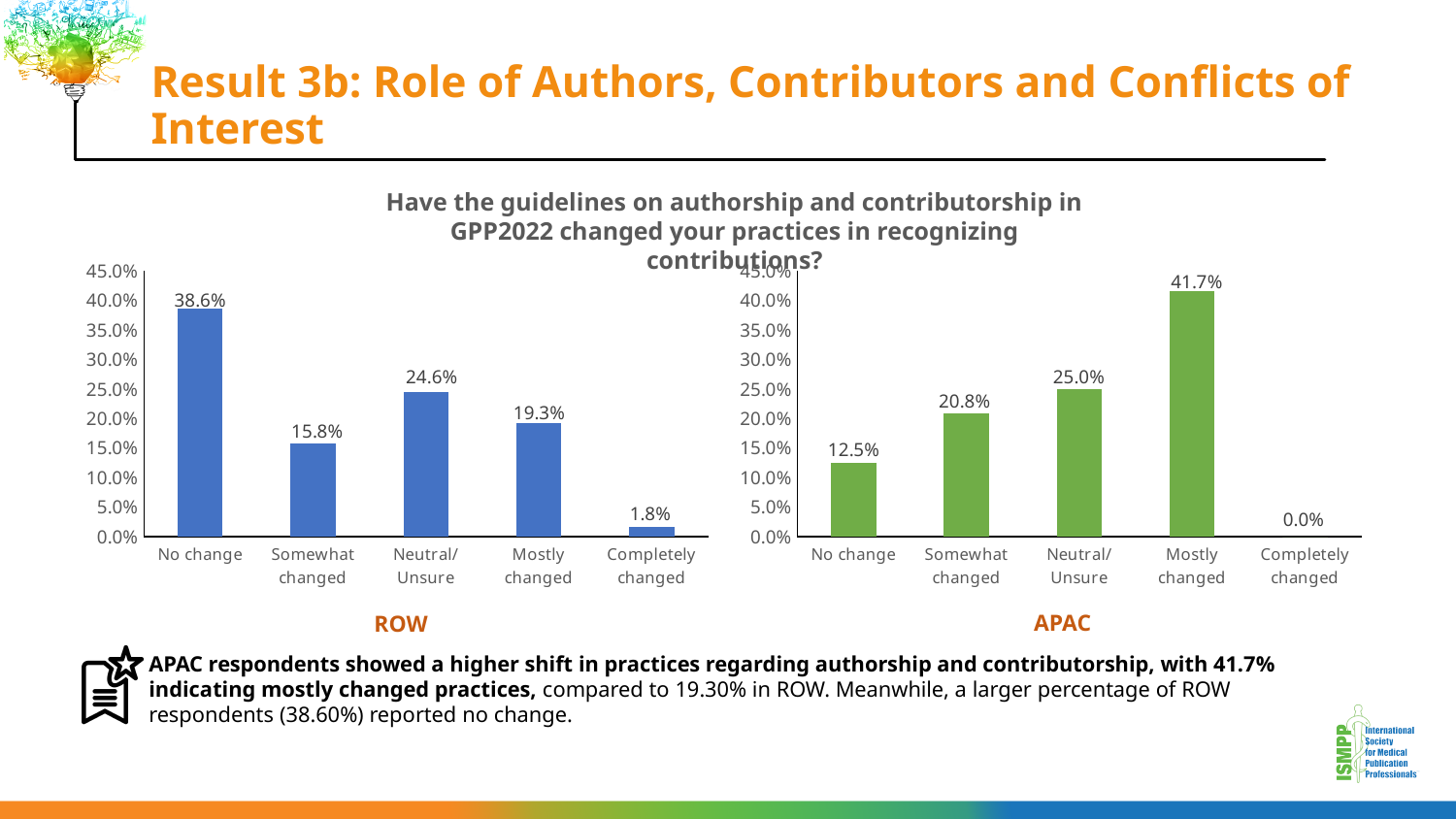
In the ROW chart, what is the value for No change? 38.6% Which is larger: Mostly changed in the ROW chart or Mostly changed in the APAC chart? APAC What colour are the bars in the APAC chart? Green In the APAC chart, what is the value for Mostly changed? 41.7% In the ROW chart, is the value for Neutral/Unsure greater or less than 20.0%? greater What type of chart is the ROW chart? Bar chart In the APAC chart, what is the value for Somewhat changed? 20.8% How many categories are shown in the APAC chart? 5 In the ROW chart, which category has the highest value? No change In the ROW chart, what is the difference between Neutral/Unsure and Somewhat changed? 8.8% In the APAC chart, which category has the lowest value? Completely changed In the APAC chart, what is the difference between Mostly changed and No change? 29.2%